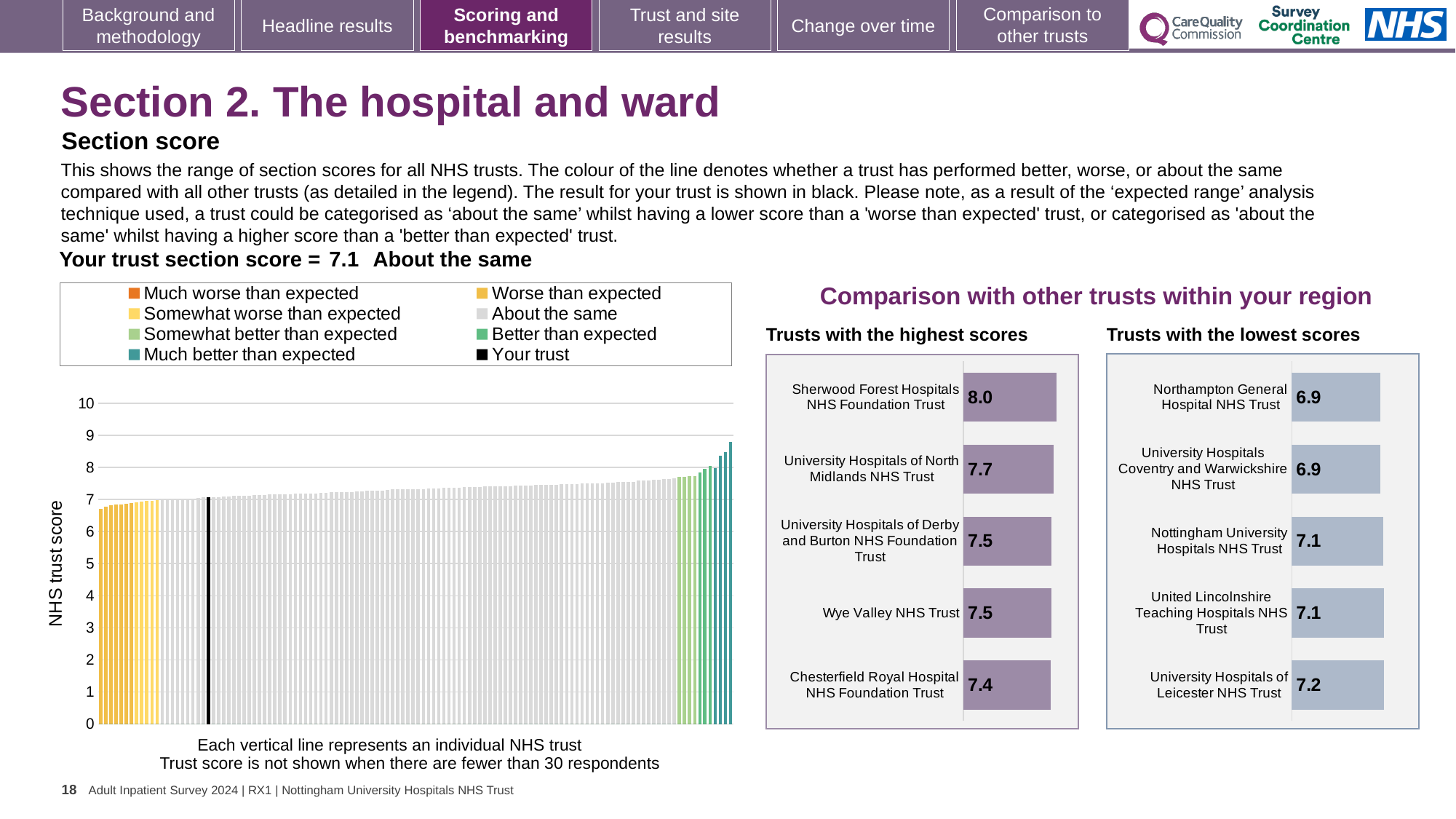
In the 'Trusts with the highest scores' chart, what is the score for Chesterfield Royal Hospital NHS Foundation Trust? 7.4 How many trusts are shown in the 'Trusts with the lowest scores' chart? 5 In the 'Trusts with the highest scores' chart, which has the larger score: University Hospitals of North Midlands NHS Trust or Wye Valley NHS Trust? University Hospitals of North Midlands NHS Trust In the 'Trusts with the lowest scores' chart, which trust has the highest score? University Hospitals of Leicester NHS Trust In the left-hand NHS trust score chart, do the values rise or fall from left to right along the x axis? rise How many entries does the legend of the left-hand NHS trust score chart list? 8 In the left-hand NHS trust score chart, is the value of the tallest bar greater or less than 8? greater What kind of chart is the large chart on the left showing NHS trust scores? bar chart In the 'Trusts with the lowest scores' chart, what is the score for Nottingham University Hospitals NHS Trust? 7.1 In the 'Trusts with the highest scores' chart, which trust has the highest score? Sherwood Forest Hospitals NHS Foundation Trust In the 'Trusts with the highest scores' chart, what is the difference between the scores of Sherwood Forest Hospitals NHS Foundation Trust and Chesterfield Royal Hospital NHS Foundation Trust? 0.6 In the 'Trusts with the highest scores' chart, what is the score for Sherwood Forest Hospitals NHS Foundation Trust? 8.0